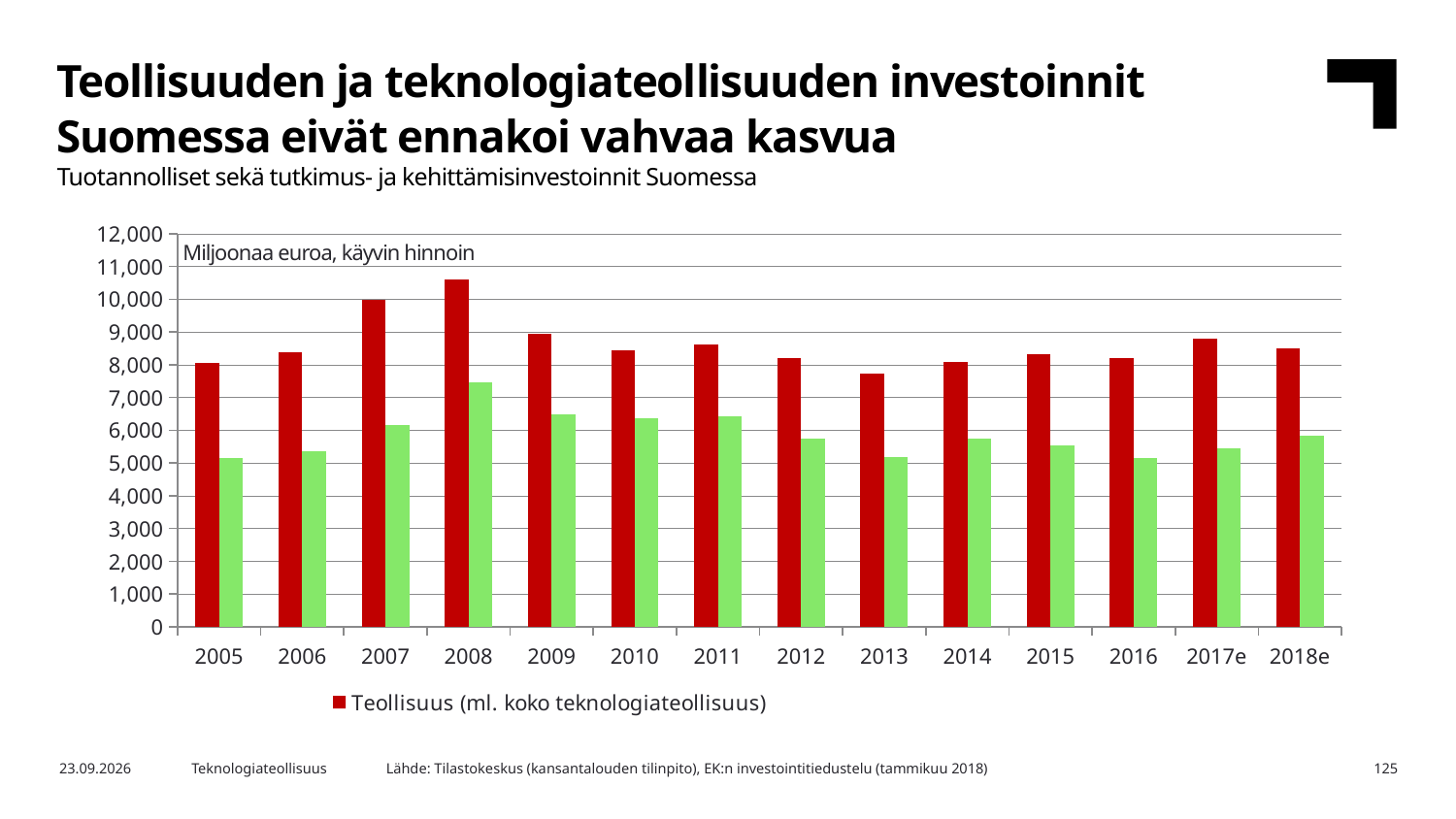
Is the green bar value for 2012 greater or less than 6,000? less How many series does the legend list? 1 In which year is the red Teollisuus bar highest? 2008 Is the red Teollisuus value for 2008 greater or less than 10,000? greater In which year is the red Teollisuus bar lowest? 2013 Do the red Teollisuus bars rise or fall from 2005 to 2008? rise What kind of chart is shown on the slide? Bar chart In which year is the green bar highest? 2008 What unit is stated in the text box inside the chart? Miljoonaa euroa, käyvin hinnoin Which is larger, the red Teollisuus bar for 2011 or for 2012? 2011 How many years (categories) are shown on the x axis? 14 Is the red Teollisuus value for 2013 greater or less than 8,000? less